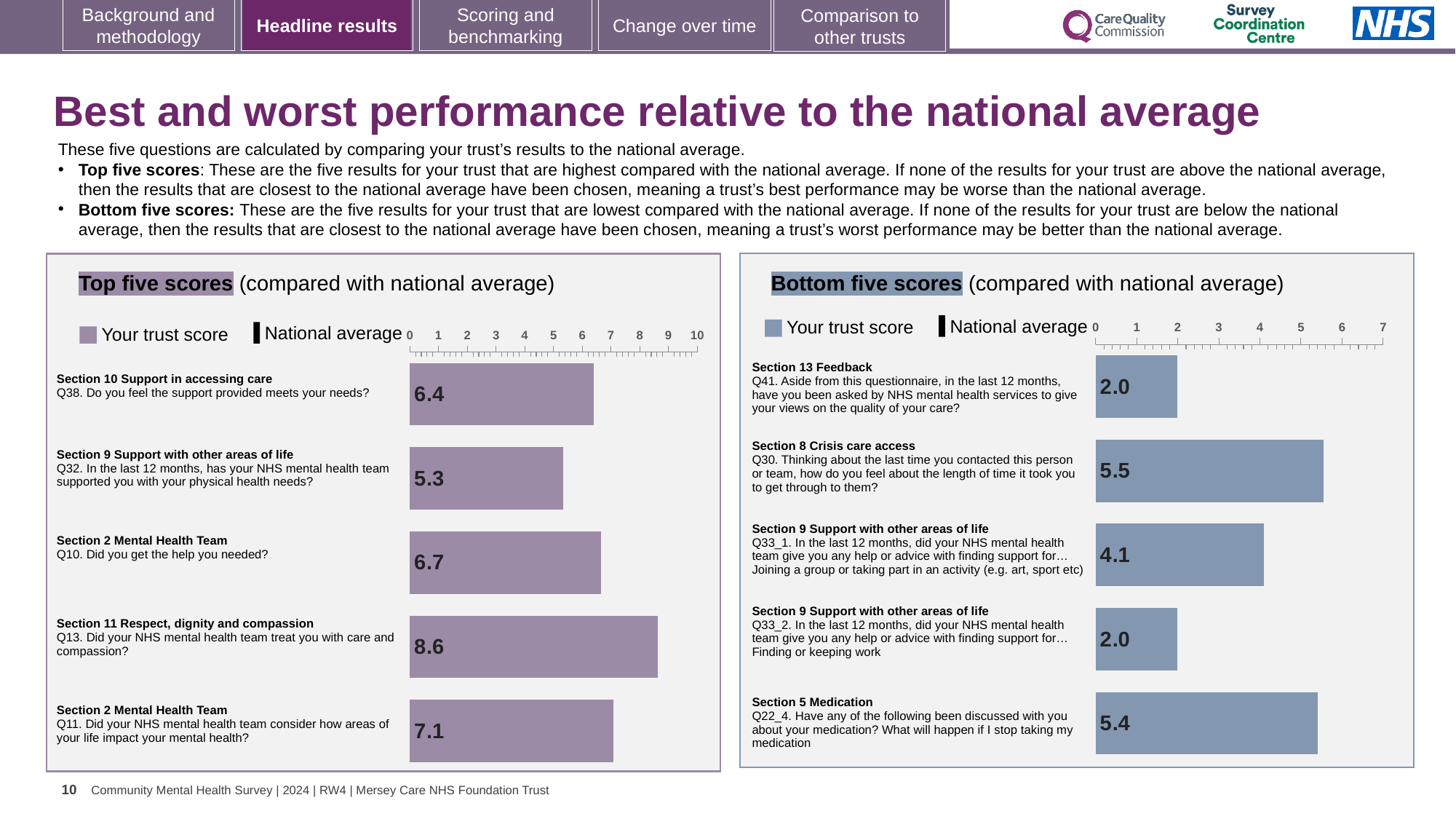
In the Bottom five scores chart, which has the larger trust score, Q30 or Q22_4? Q30 In the Bottom five scores chart, what is the trust score for Q41 (Section 13 Feedback)? 2.0 In the Top five scores chart, what is the trust score for Q13 (Did your NHS mental health team treat you with care and compassion?)? 8.6 In the Top five scores chart, which question has the lowest trust score? Q32 In the Top five scores chart, what is the difference between the trust scores for Q13 and Q32? 3.3 In the Bottom five scores chart, what is the difference between the trust scores for Q30 and Q33_1? 1.4 What kind of chart is the Top five scores chart? Bar chart In the Top five scores chart, what is the trust score for Q32 (supported you with your physical health needs)? 5.3 How many questions are plotted in the Bottom five scores chart? 5 In the Bottom five scores chart, what is the trust score for Q30 (Crisis care access)? 5.5 How many series does the legend of the Top five scores chart list? 2 In the Top five scores chart, which question has the highest trust score? Q13